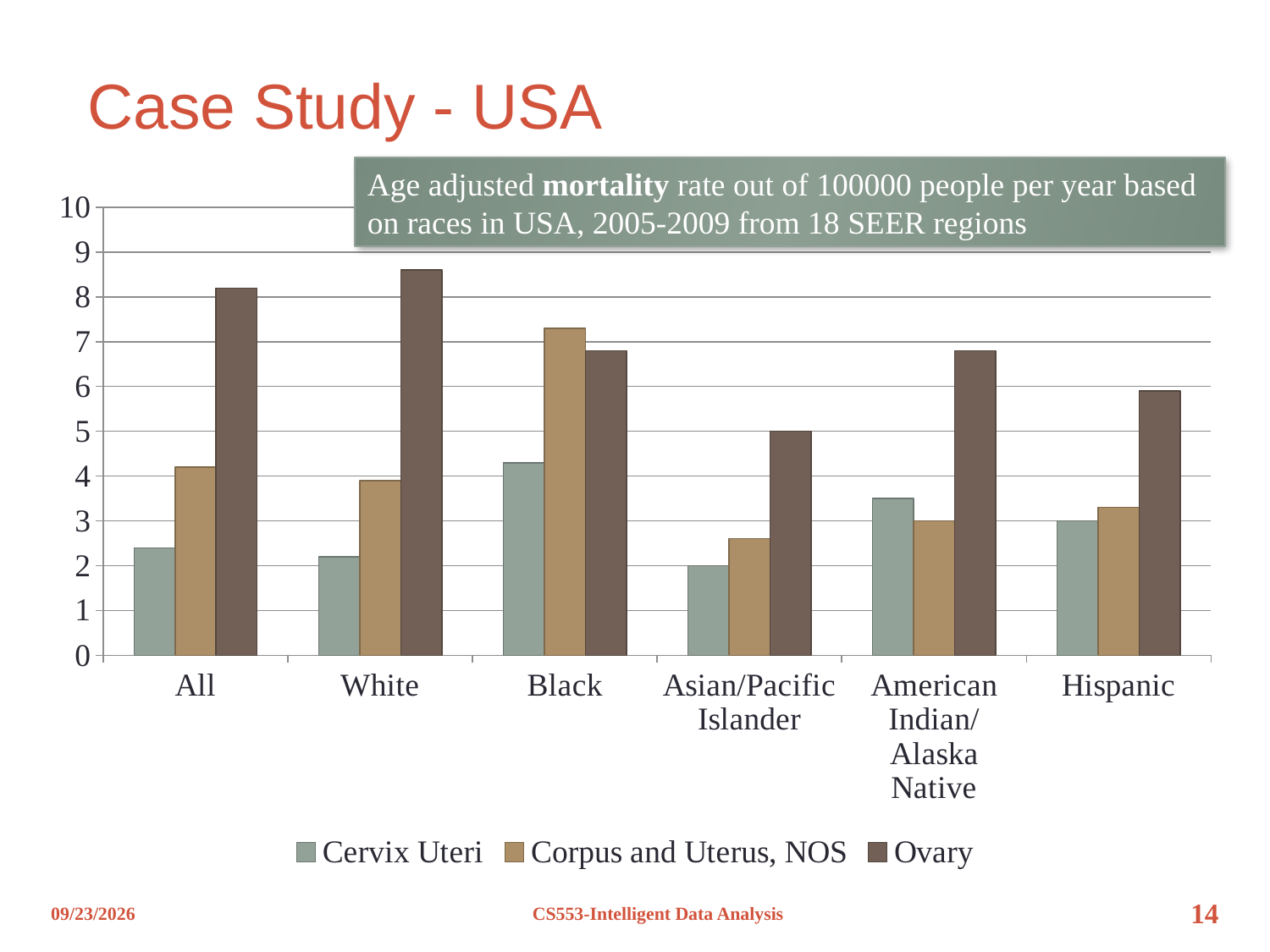
Which series is shown in the darkest brown bars according to the legend? Ovary Is the Corpus and Uterus, NOS mortality rate for Black greater or less than 7? greater What kind of chart is shown on the slide? bar chart How many series does the legend list? 3 How many race categories are shown on the x axis? 6 Is the Ovary mortality rate for White greater or less than 8? greater For Black, which is larger: the Corpus and Uterus, NOS rate or the Ovary rate? Corpus and Uterus, NOS For American Indian/Alaska Native, which is larger: the Cervix Uteri rate or the Corpus and Uterus, NOS rate? Cervix Uteri Which category has the highest Cervix Uteri mortality rate? Black Which category has the highest Ovary mortality rate? White Which category has the lowest Ovary mortality rate? Asian/Pacific Islander Which category has the lowest Corpus and Uterus, NOS mortality rate? Asian/Pacific Islander